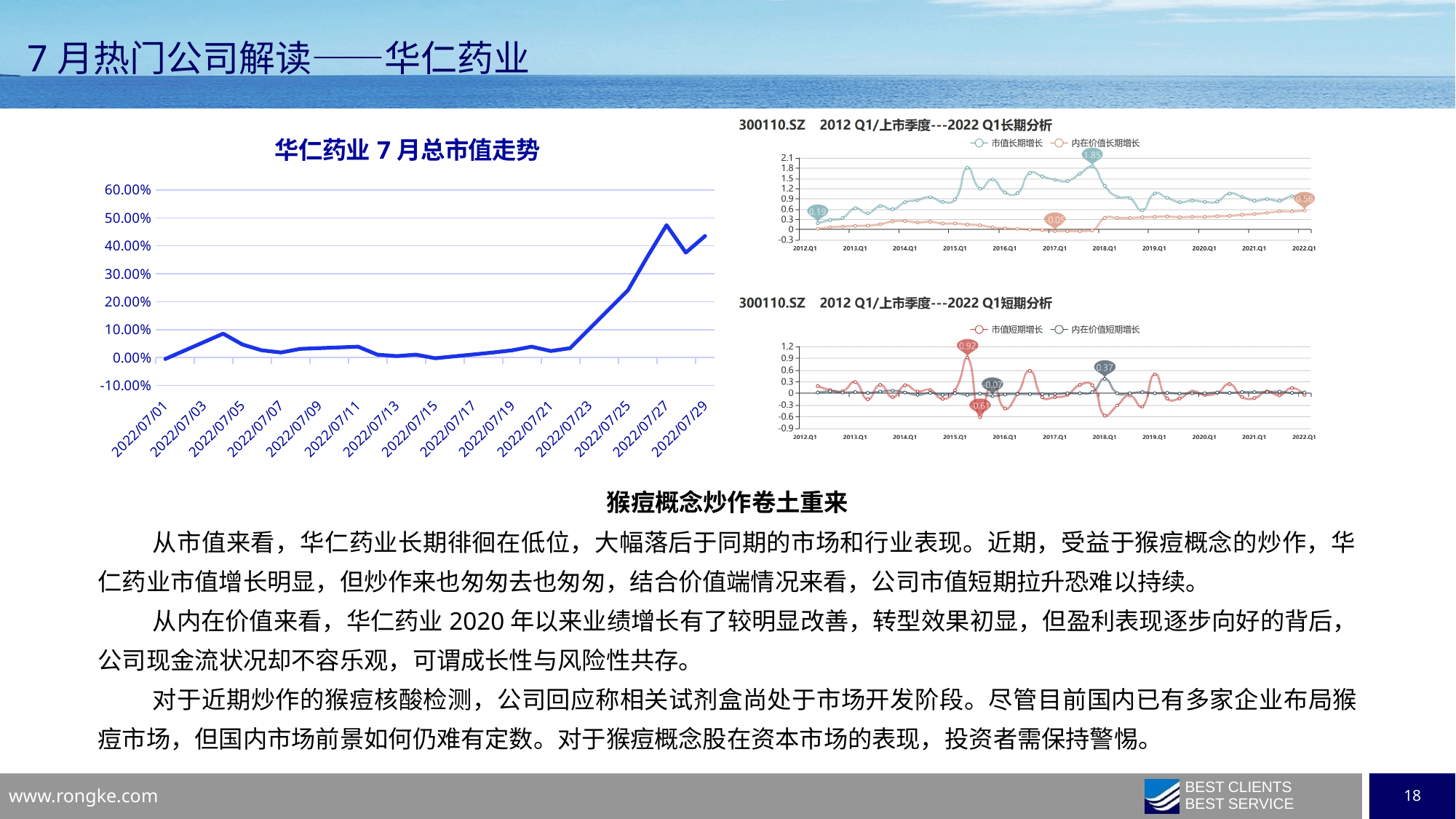
In the '华仁药业 7 月总市值走势' chart, on which date does the line reach its highest value? 2022/07/27 How many series does the legend of the '300110.SZ 2012 Q1/上市季度---2022 Q1长期分析' chart list? 2 In the '300110.SZ 2012 Q1/上市季度---2022 Q1长期分析' chart, what is the labelled value of 市值长期增长 at 2022.Q1? 0.56 In the '华仁药业 7 月总市值走势' chart, does the line overall rise or fall from 2022/07/01 to 2022/07/29? rise In the '华仁药业 7 月总市值走势' chart, is the value for 2022/07/27 greater or less than 40.00%? greater In the '300110.SZ 2012 Q1/上市季度---2022 Q1长期分析' chart, what is the highest labelled value of 市值长期增长? 1.85 In the '华仁药业 7 月总市值走势' chart, which is larger: the value for 2022/07/25 or the value for 2022/07/21? 2022/07/25 What kind of chart is the '华仁药业 7 月总市值走势' chart on the left? line chart In the '华仁药业 7 月总市值走势' chart, is the value for 2022/07/05 greater or less than 20.00%? less In the '300110.SZ 2012 Q1/上市季度---2022 Q1长期分析' chart, what is the difference between the labelled peak value 1.85 and the 2022.Q1 value 0.56 of 市值长期增长? 1.29 In the '300110.SZ 2012 Q1/上市季度---2022 Q1短期分析' chart, what is the lowest labelled value of 市值短期增长? -0.61 How many charts are shown on the slide? 3